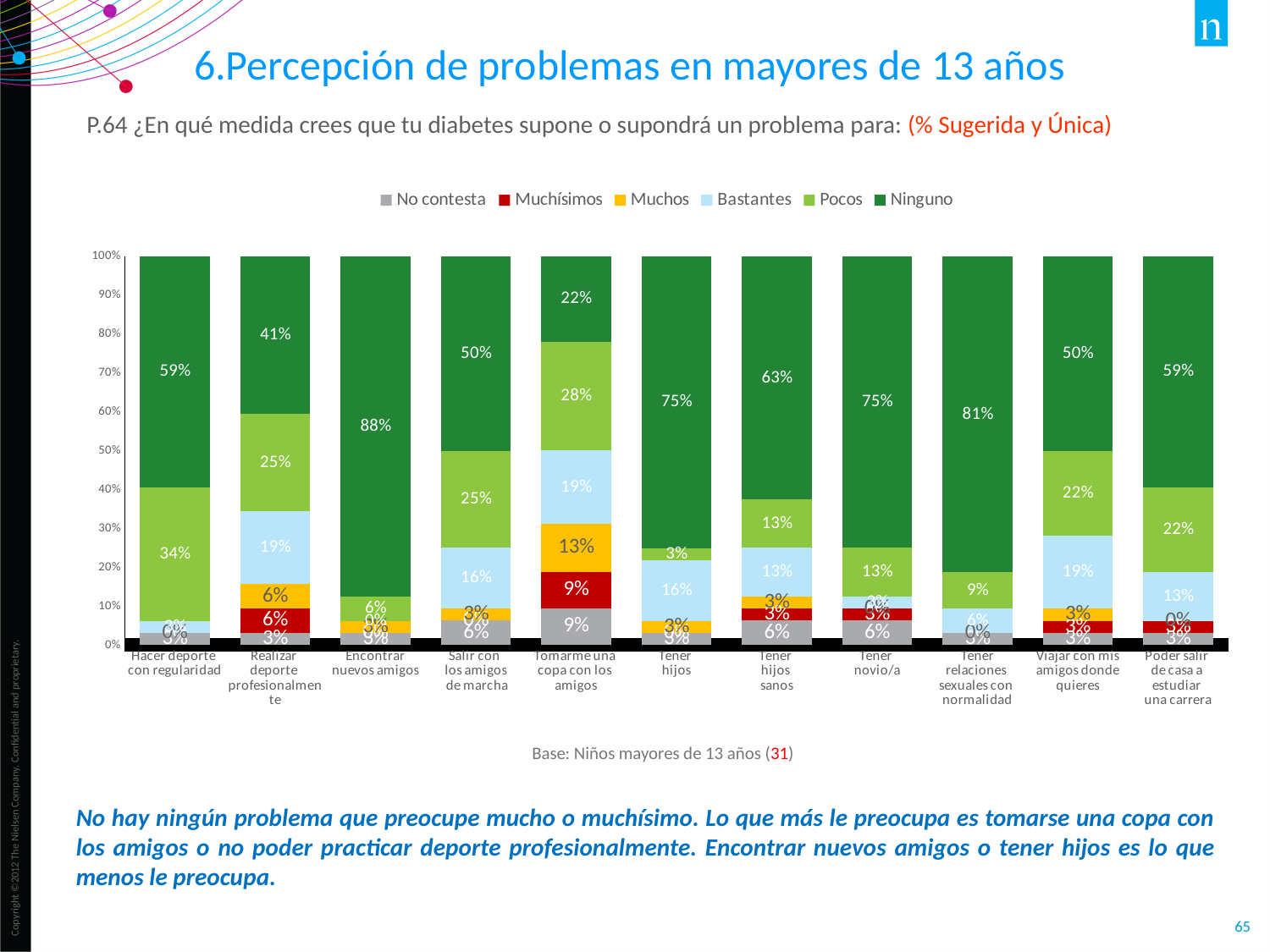
What is the 'Pocos' value for 'Hacer deporte con regularidad'? 34% How many series does the legend list? 6 What is the 'Ninguno' value for 'Encontrar nuevos amigos'? 88% How many categories are shown along the x axis? 11 Which series is shown in dark green in the legend? Ninguno Which category has the highest 'Ninguno' value? Encontrar nuevos amigos What is the 'Ninguno' value for 'Tomarme una copa con los amigos'? 22% Which has a larger 'Ninguno' value, 'Tener hijos' or 'Tener hijos sanos'? Tener hijos What is the 'Muchos' value for 'Tomarme una copa con los amigos'? 13% Which category has the lowest 'Ninguno' value? Tomarme una copa con los amigos What kind of chart is shown on the slide? stacked bar chart What is the difference between the 'Ninguno' values for 'Tener relaciones sexuales con normalidad' and 'Realizar deporte profesionalmente'? 40%